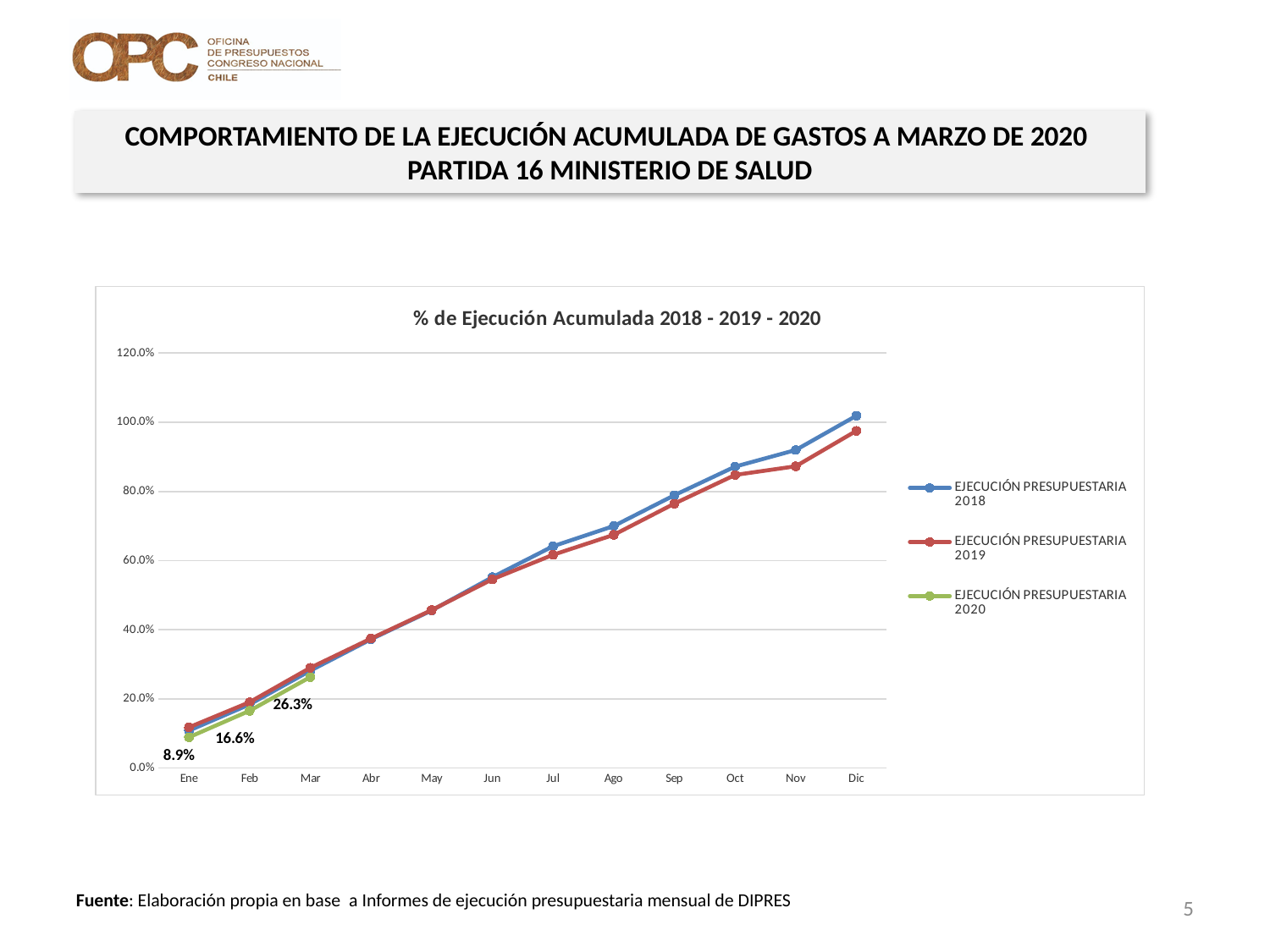
Is the value for EJECUCIÓN PRESUPUESTARIA 2018 in Nov greater or less than 80%? greater What is the value of EJECUCIÓN PRESUPUESTARIA 2020 in Feb? 16.6% What is the title of the chart? % de Ejecución Acumulada 2018 - 2019 - 2020 By how many percentage points did EJECUCIÓN PRESUPUESTARIA 2020 increase from Feb to Mar? 9.7 percentage points What is the value of EJECUCIÓN PRESUPUESTARIA 2020 in Mar? 26.3% How many series does the legend list? 3 Do the values of EJECUCIÓN PRESUPUESTARIA 2018 rise or fall from Ene to Dic? Rise By how many percentage points did EJECUCIÓN PRESUPUESTARIA 2020 increase from Ene to Mar? 17.4 percentage points What kind of chart is shown on the slide? Line chart What is the value of EJECUCIÓN PRESUPUESTARIA 2020 in Ene? 8.9% How many months are shown on the x axis? 12 Which series is higher in Dic, EJECUCIÓN PRESUPUESTARIA 2018 or EJECUCIÓN PRESUPUESTARIA 2019? EJECUCIÓN PRESUPUESTARIA 2018